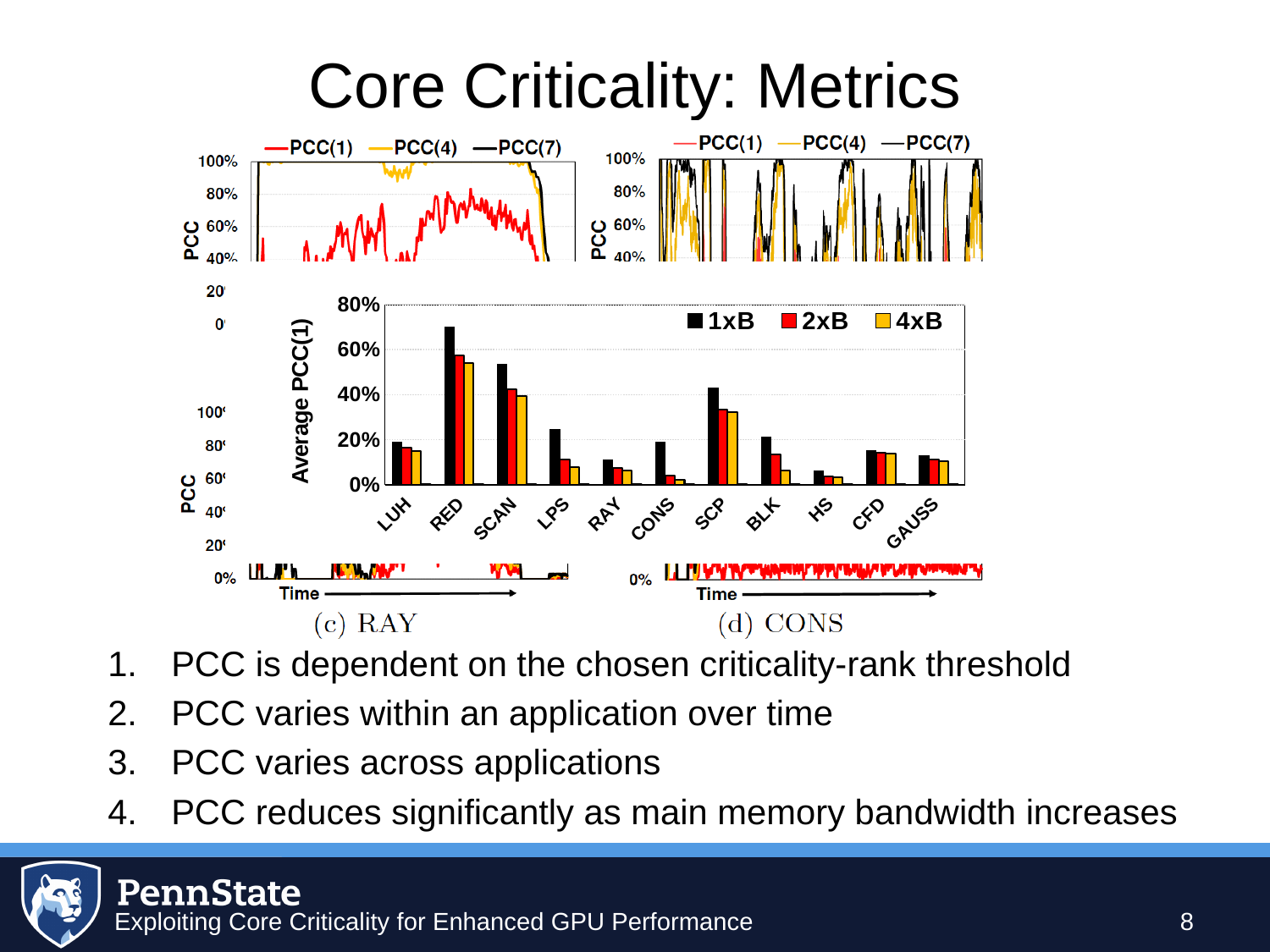
In the bar chart, is the 1xB value for SCP greater or less than 40%? greater In the bar chart, is the 1xB value for RED greater or less than 60%? greater In the bar chart, how many application categories are shown on the x axis? 11 In the bar chart, which is larger for 1xB: RED or SCAN? RED What kind of chart is the chart labelled 'Average PCC(1)'? bar chart What is the y-axis label of the bar chart? Average PCC(1) In the bar chart, which application has the highest 1xB value? RED In the bar chart, how many series does the legend list? 3 In the bar chart, which application has the lowest 4xB value? CONS In the bar chart, for RED, do the values rise or fall going from 1xB to 2xB to 4xB? fall In the bar chart, is the 1xB value for LUH greater or less than 40%? less In the line chart labelled '(c) RAY', what series does the legend list? PCC(1), PCC(4), PCC(7)